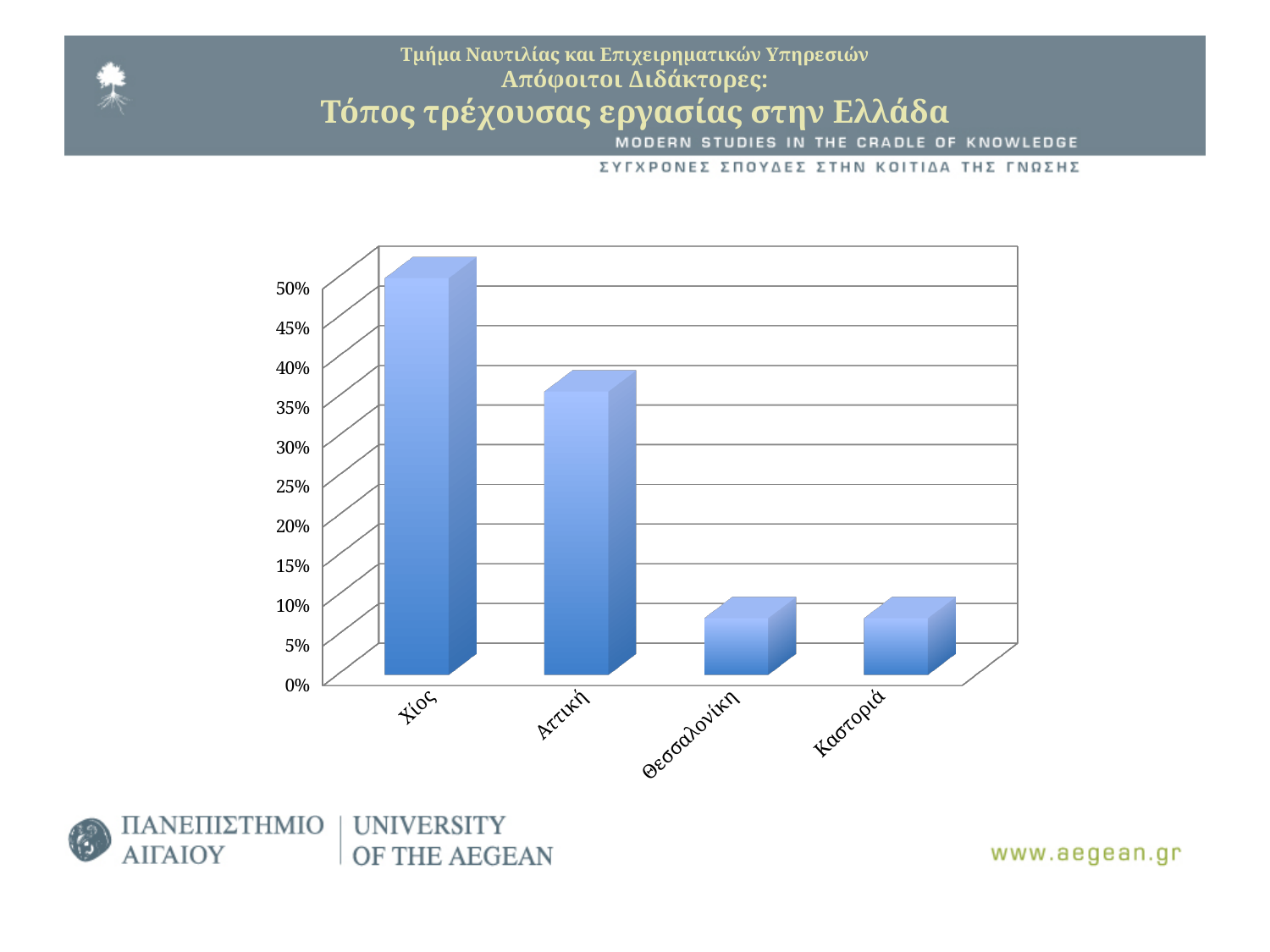
Is the value for Χίος greater or less than 40%? greater Is the value for Αττική greater or less than 40%? less How many categories are shown on the x axis of the chart? 4 Which category has the highest value in the chart? Χίος Do the bar values generally rise or fall from left to right along the x axis? fall Which has the larger value, Χίος or Αττική? Χίος Is the value for Θεσσαλονίκη greater or less than 10%? less Which has the larger value, Αττική or Θεσσαλονίκη? Αττική What kind of chart is shown on the slide? bar chart What is the title of the slide containing the chart? Τόπος τρέχουσας εργασίας στην Ελλάδα